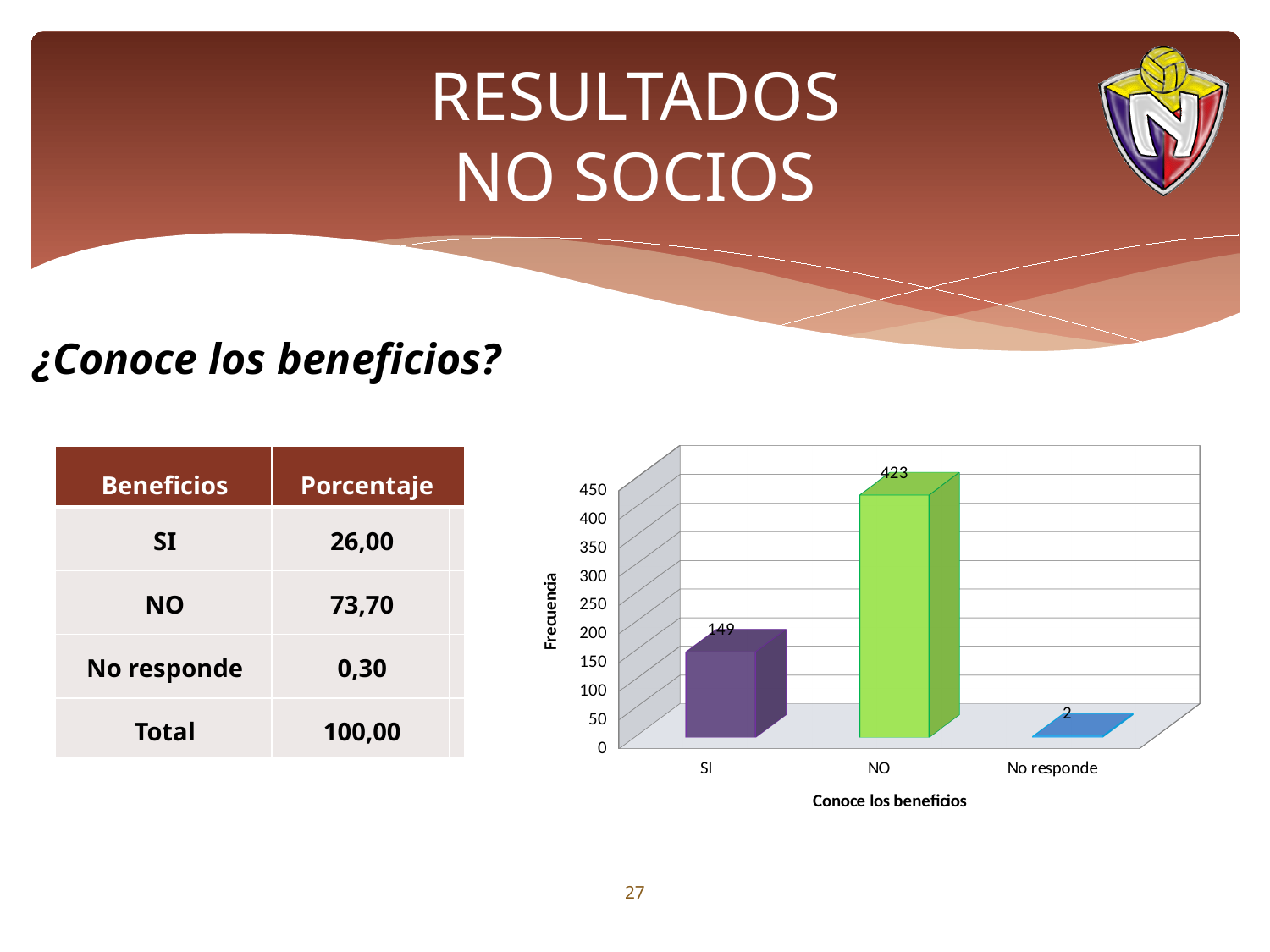
What kind of chart is shown on the slide? bar chart What is the value for No responde in the chart? 2 What is the label of the vertical axis of the chart? Frecuencia How many categories are shown on the x axis of the chart? 3 What is the difference between the values for NO and SI? 274 What is the value for SI in the chart? 149 What is the value for NO in the chart? 423 Is the value for NO greater or less than 400? greater Which category has the lowest value in the chart? No responde Which is larger, the value for SI or the value for No responde? SI What is the label of the horizontal axis of the chart? Conoce los beneficios Which category has the highest value in the chart? NO